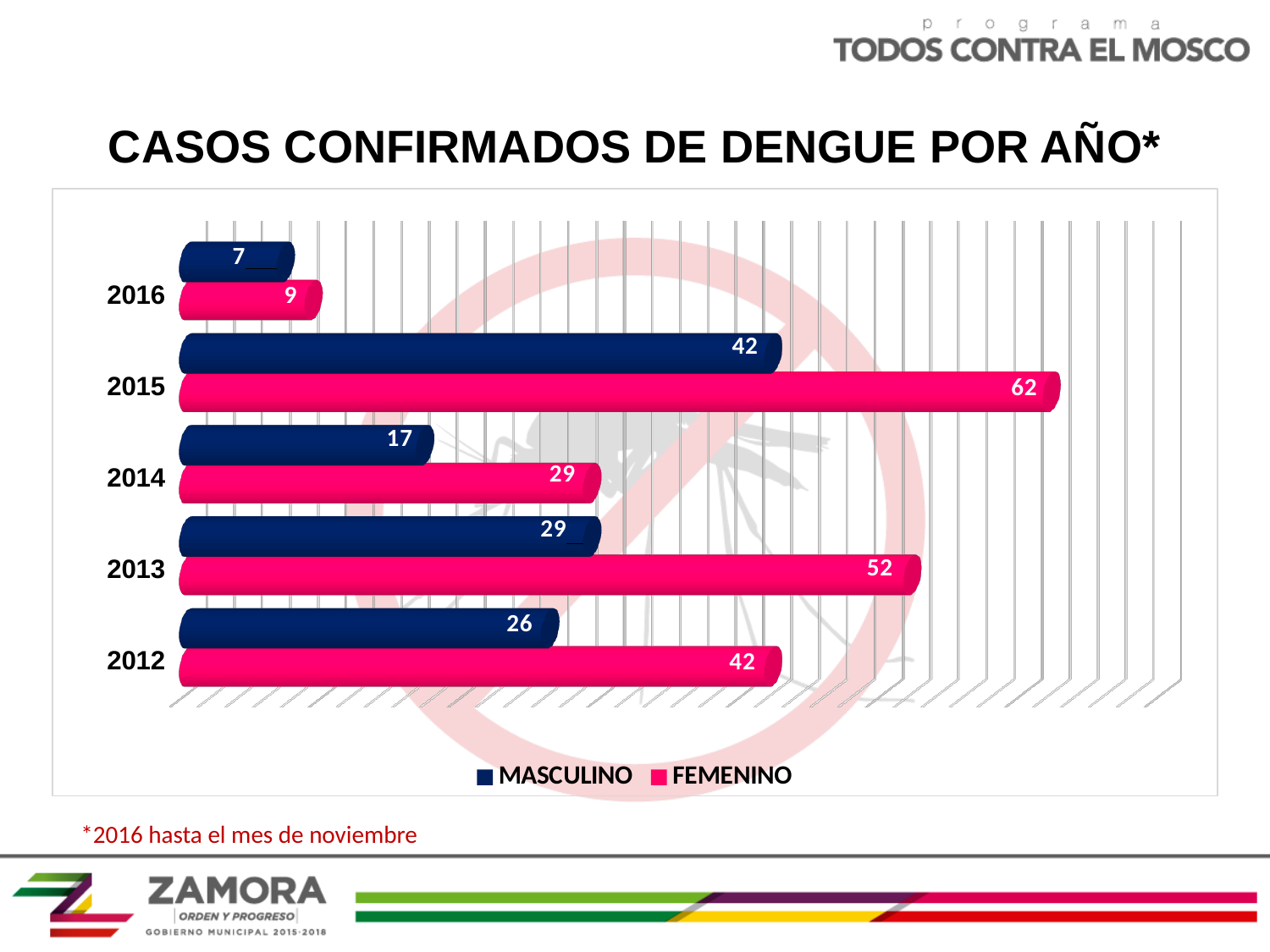
What is the title of the chart? CASOS CONFIRMADOS DE DENGUE POR AÑO* Which year has the highest FEMENINO value? 2015 What is the difference between the MASCULINO values for 2013 and 2012? 3 How many years are shown on the chart? 5 What is the FEMENINO value for 2016? 9 What is the FEMENINO value for 2013? 52 What is the MASCULINO value for 2015? 42 How many series does the legend list? 2 Which year has the lowest MASCULINO value? 2016 What is the difference between the FEMENINO and MASCULINO values for 2015? 20 What kind of chart is shown on the slide? Bar chart Which is larger for 2014, the MASCULINO value or the FEMENINO value? FEMENINO